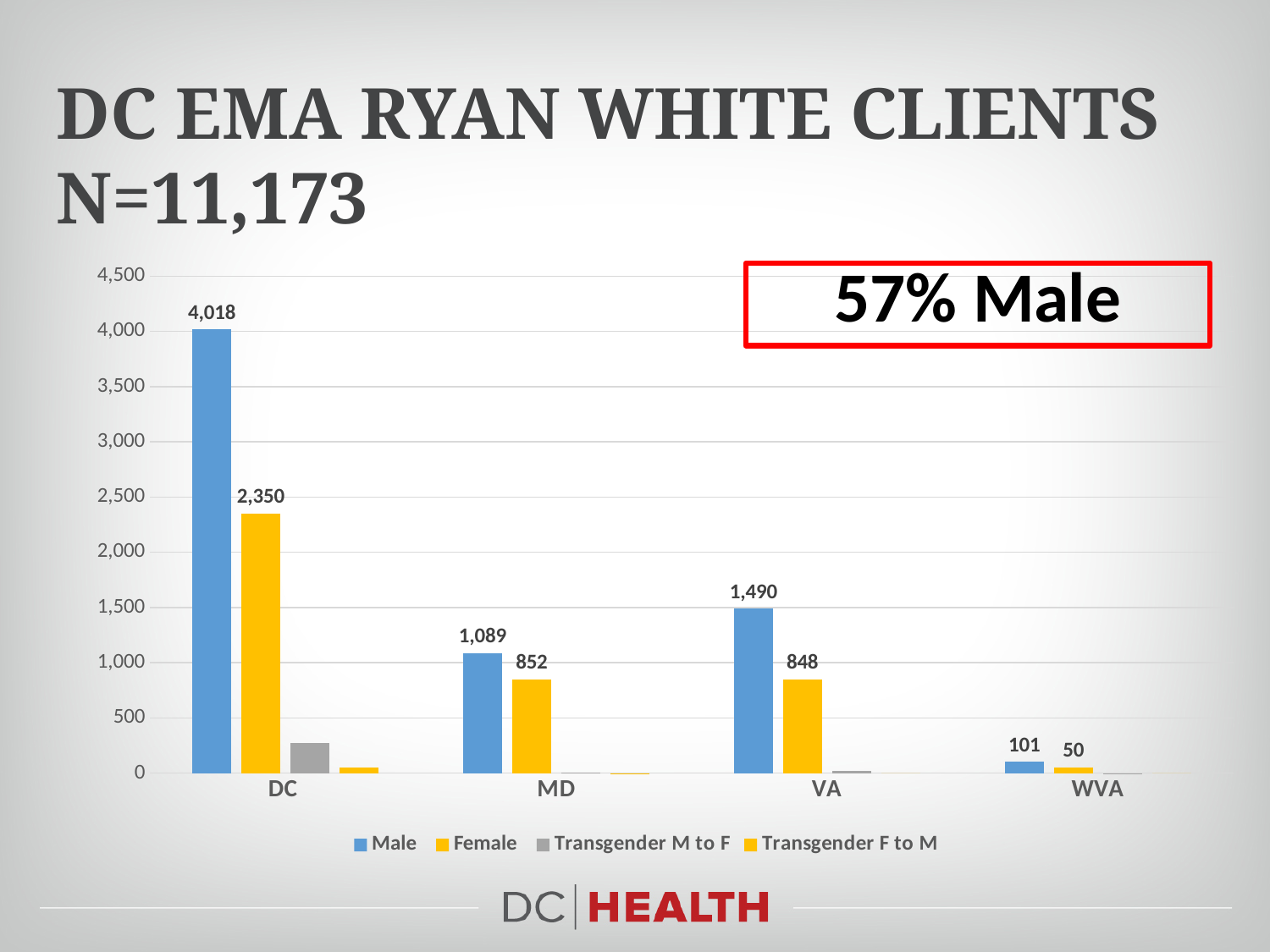
Which jurisdiction has the lowest number of Female clients? WVA What is the difference between Male and Female clients in DC? 1,668 What is the number of Female clients in WVA? 50 What is the number of Female clients in VA? 848 Which jurisdiction has the highest number of Male clients? DC What is the number of Male clients in MD? 1,089 What kind of chart is shown on the slide? bar chart How many jurisdictions are shown on the x axis? 4 Which is larger, the number of Male clients in VA or in MD? VA What is the number of Male clients in DC? 4,018 How many series does the legend list? 4 Is the value for Transgender M to F clients in DC greater or less than 500? less